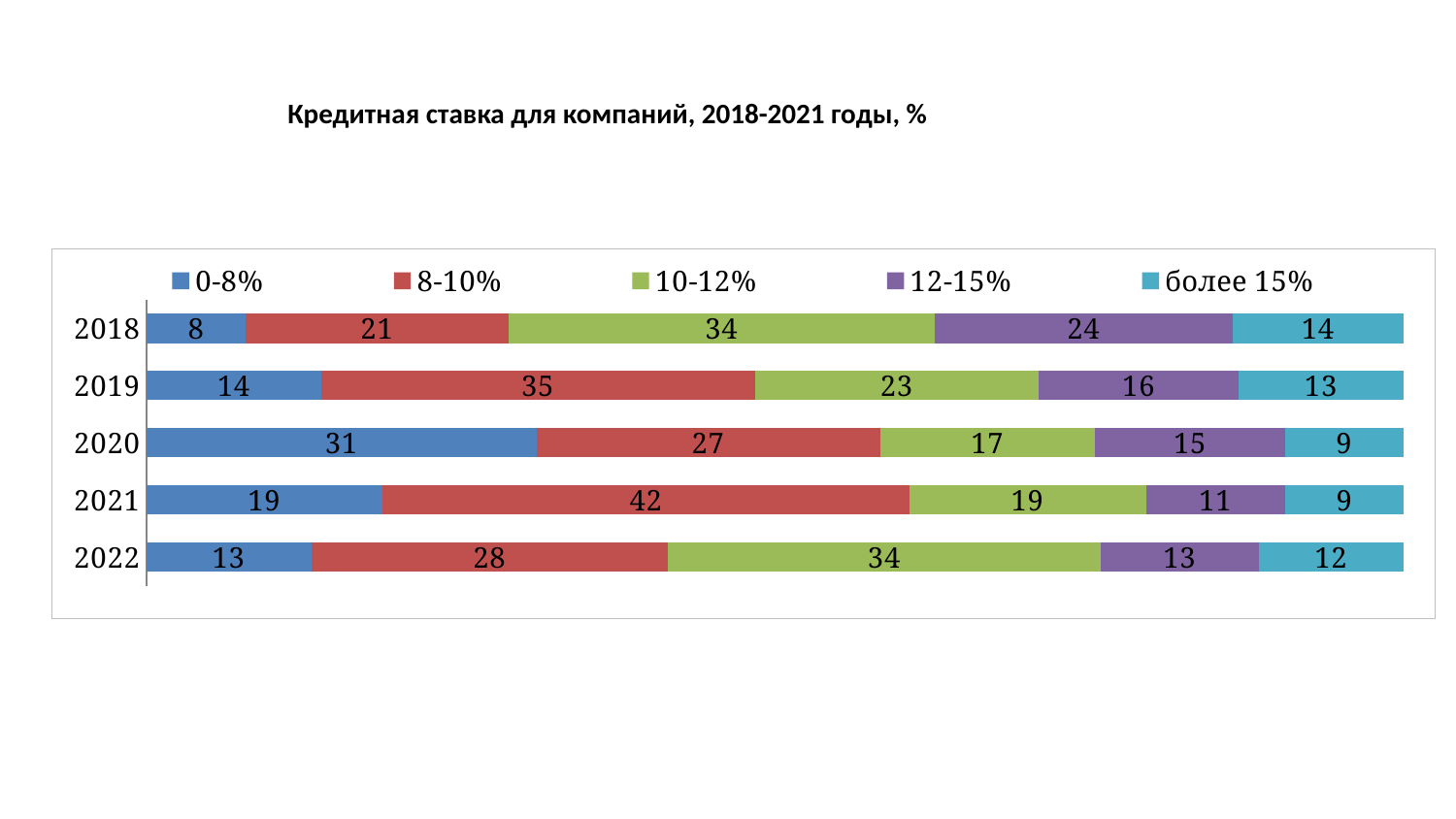
What is the difference between the 10-12% values in 2018 and 2020? 17 What is the title of the chart? Кредитная ставка для компаний, 2018-2021 годы, % What is the value for the 'более 15%' series in 2018? 14 In which year is the 12-15% series lowest? 2021 What type of chart is shown on the slide? Stacked bar chart Which is larger: the 8-10% value in 2019 or the 8-10% value in 2022? 2019 What is the total of the stacked bar for 2021? 100 How many series does the legend list? 5 What is the value for the 0-8% series in 2020? 31 What is the value for the 8-10% series in 2021? 42 How many years (categories) are shown on the chart? 5 In which year is the 0-8% series highest? 2020